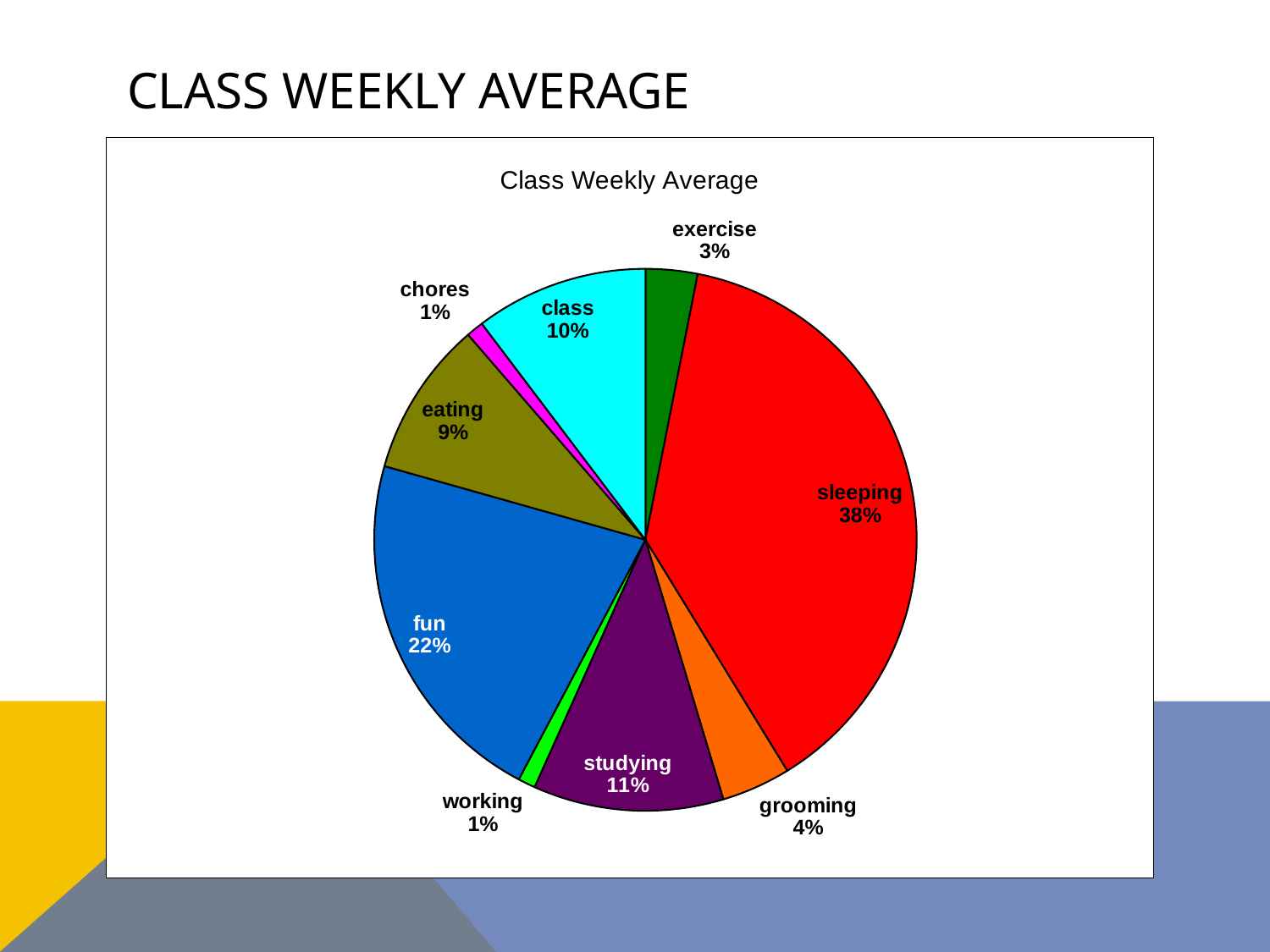
What kind of chart is shown on the slide? pie chart Which is larger, the share for class or the share for eating? class What colour is the sleeping slice? red What percentage is shown for studying? 11% Which category has the largest slice of the pie? sleeping What percentage is shown for eating? 9% How many slices does the pie chart have? 9 What is the title of the chart? Class Weekly Average What share of the pie does sleeping take? 38% What percentage is shown for fun? 22% What is the difference in percentage points between sleeping and fun? 16 What is the difference in percentage points between studying and grooming? 7